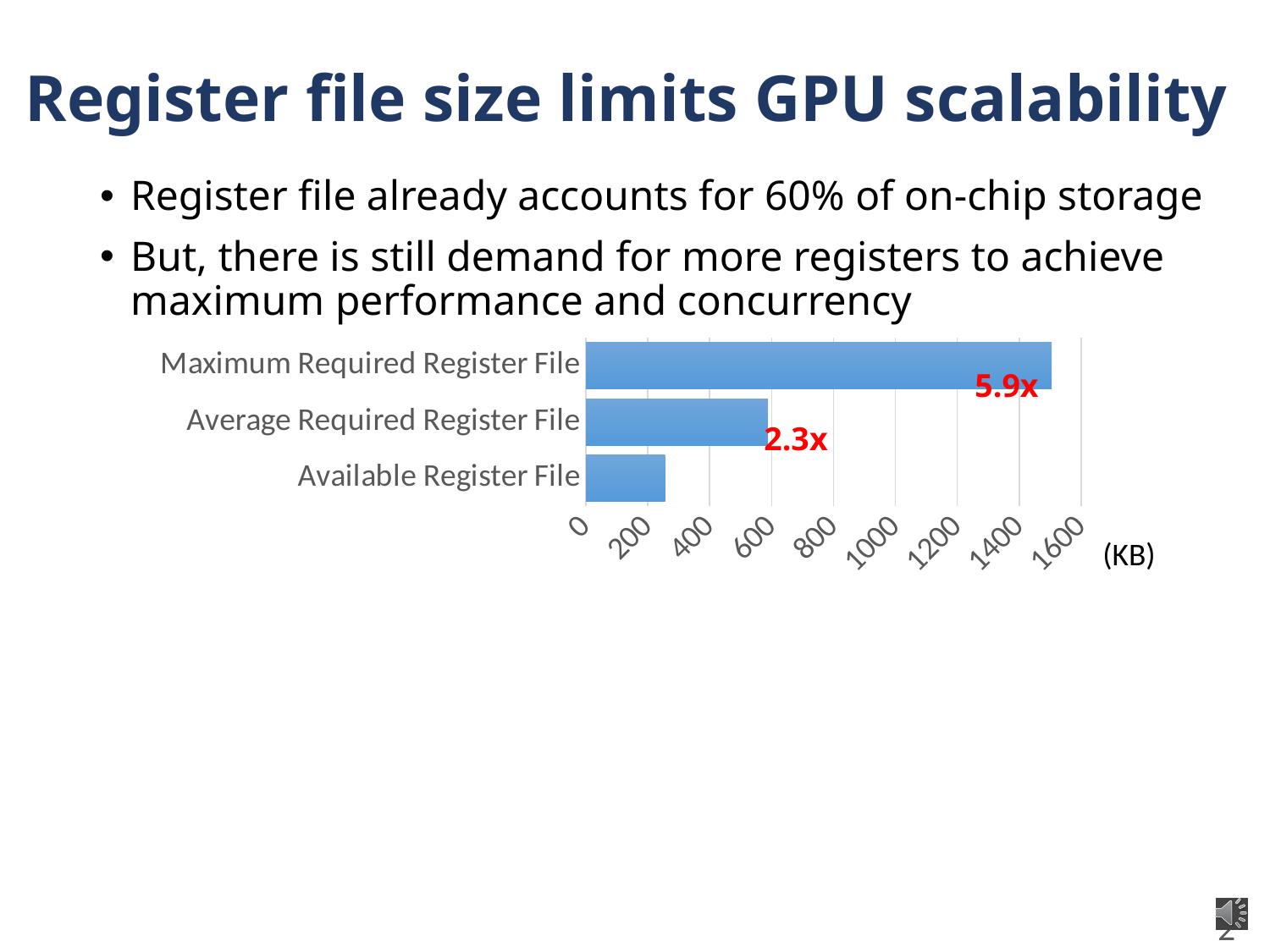
Is the value for Average Required Register File greater or less than 400? greater Is the value for Available Register File greater or less than 200? greater Is the value for Available Register File greater or less than 400? less What kind of chart is shown on the slide? bar chart Which category has the shortest bar? Available Register File What unit is shown next to the x axis of the chart? (KB) Which is larger, the value for Average Required Register File or the value for Available Register File? Average Required Register File How many categories does the chart show? 3 What red annotation is printed next to the Maximum Required Register File bar? 5.9x Which category has the longest bar? Maximum Required Register File